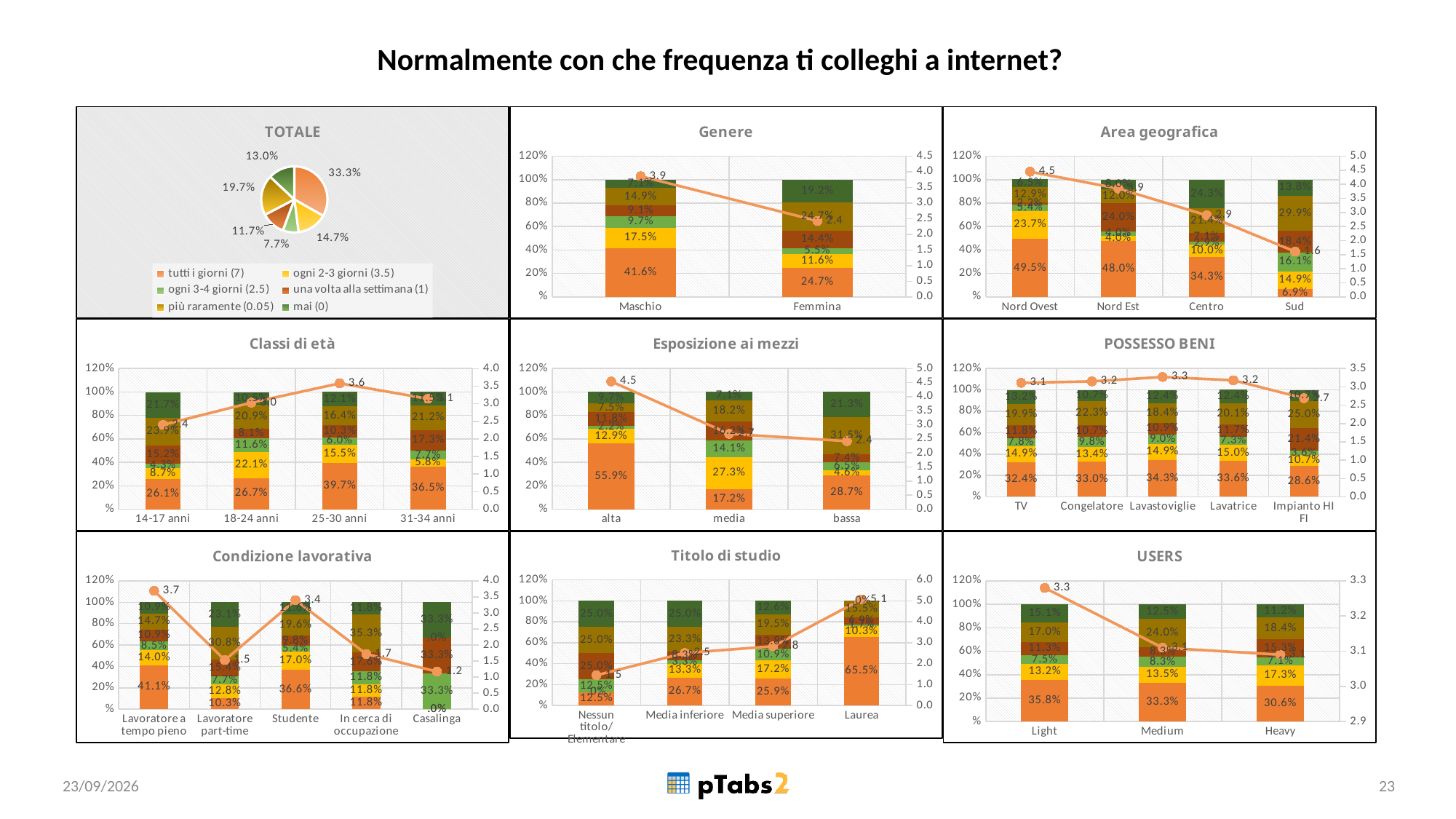
In the Condizione lavorativa chart, which category has the lowest line value? Casalinga In the USERS chart, do the bottom segment values rise or fall from Light to Heavy? fall How many entries does the legend of the TOTALE chart list? 6 In the Titolo di studio chart, is the bottom segment value for Laurea larger than that for Media inferiore? Yes In the Esposizione ai mezzi chart, what is the bottom segment value for alta? 55.9% In the POSSESSO BENI chart, how many categories are shown on the x axis? 5 In the Genere chart, what is the line value for Femmina? 2.4 In the Area geografica chart, which area has the lowest bottom (tutti i giorni) segment? Sud In the Classi di età chart, which age class has the highest line value? 25-30 anni In the Area geografica chart, what is the difference between the bottom segment values of Nord Ovest and Nord Est? 1.5% In the Genere chart, what is the bottom (tutti i giorni) segment value for Maschio? 41.6% In the TOTALE pie chart, what share is shown for the largest slice? 33.3%